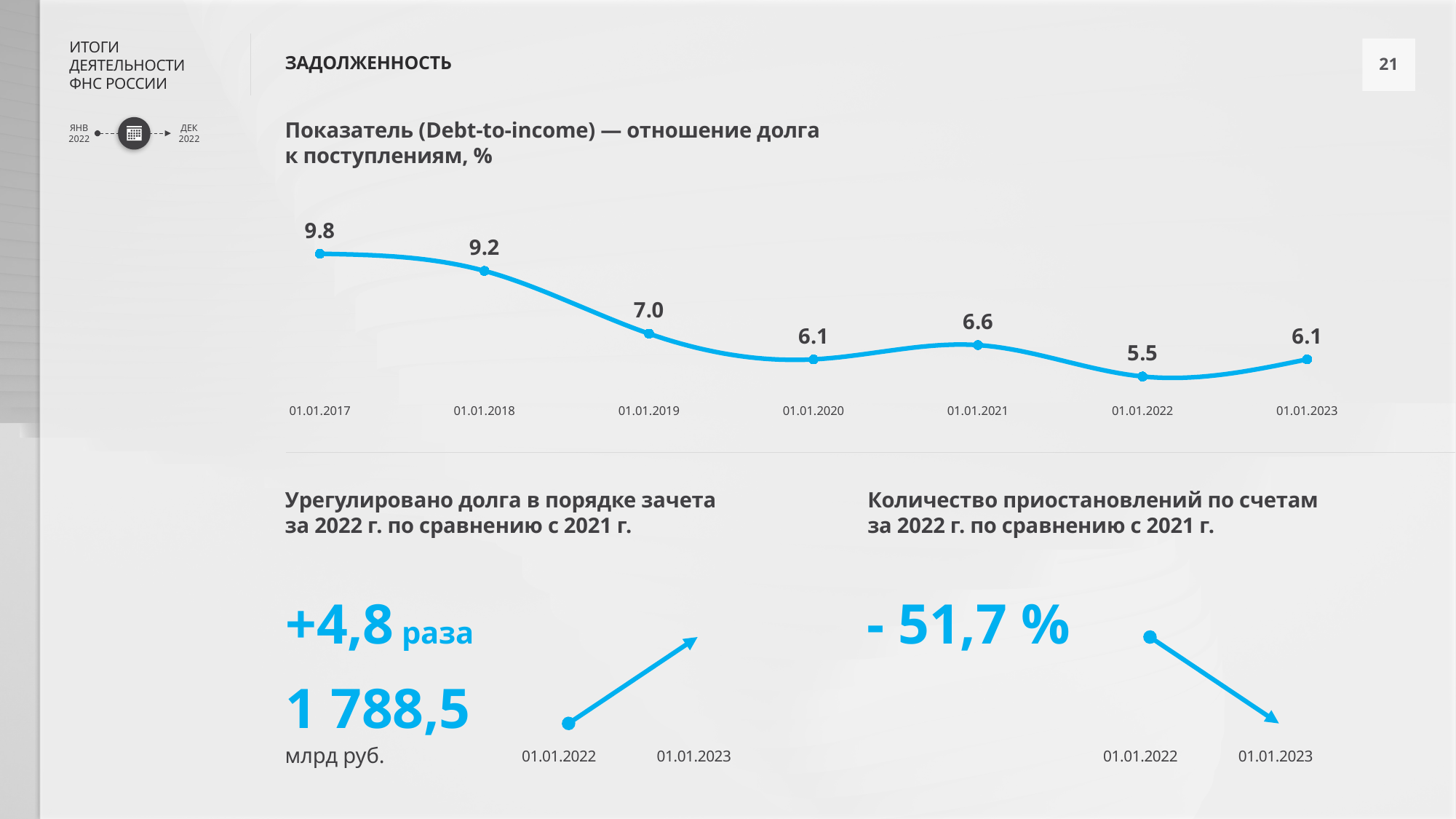
What is the Debt-to-income value for 01.01.2021? 6.6 What is the Debt-to-income value for 01.01.2023? 6.1 What is the Debt-to-income value for 01.01.2019? 7.0 How many data points are plotted on the Debt-to-income chart? 7 What is the Debt-to-income value for 01.01.2017? 9.8 Which is larger, the Debt-to-income value for 01.01.2018 or for 01.01.2019? 01.01.2018 Does the Debt-to-income value rise or fall from 01.01.2017 to 01.01.2020? fall Which date has the highest Debt-to-income value? 01.01.2017 What is the difference between the Debt-to-income values for 01.01.2017 and 01.01.2023? 3.7 Which date has the lowest Debt-to-income value? 01.01.2022 What kind of chart is used to show the Debt-to-income indicator? line chart What is the difference between the Debt-to-income values for 01.01.2021 and 01.01.2022? 1.1